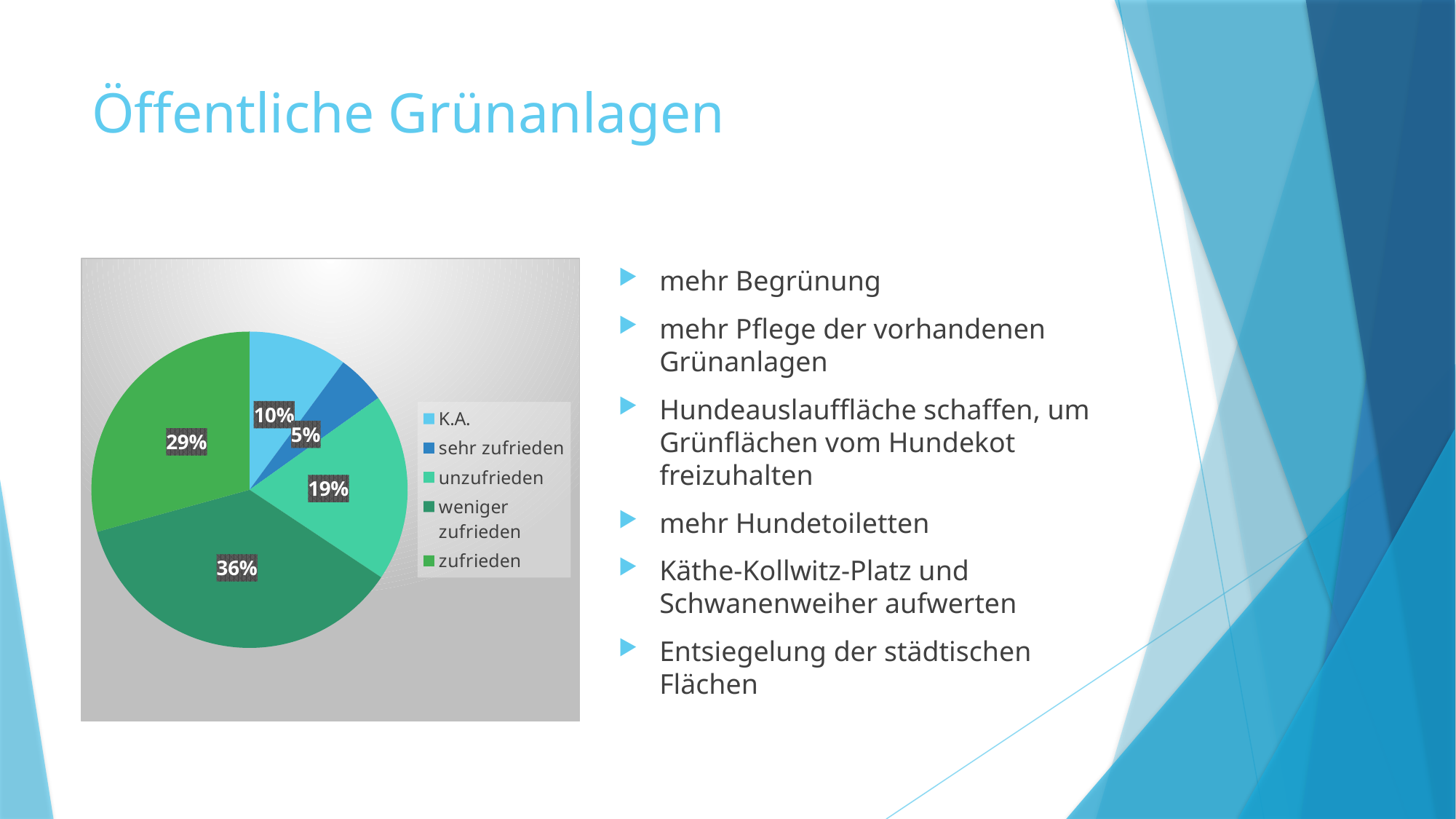
How many categories does the pie chart show? 5 What share of the pie does "K.A." have? 10% What share of the pie does "unzufrieden" have? 19% What share of the pie does "weniger zufrieden" have? 36% What kind of chart is shown on the slide? pie chart Which category has the largest slice of the pie? weniger zufrieden What is the difference between the shares of "weniger zufrieden" and "zufrieden"? 7% Which legend entry is shown in the lightest blue colour? K.A. Which is larger, the share of "unzufrieden" or the share of "K.A."? unzufrieden Which category has the smallest slice of the pie? sehr zufrieden